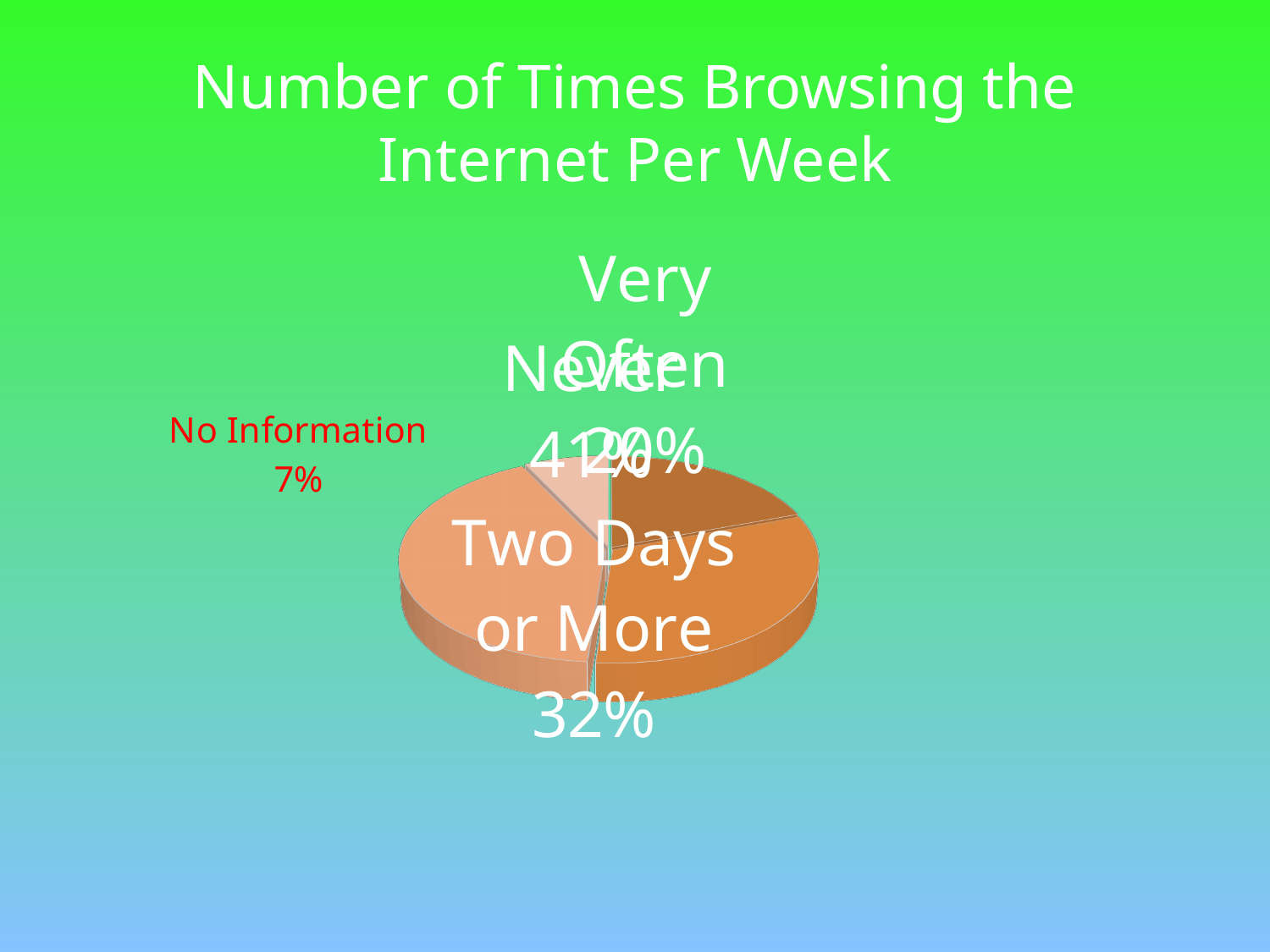
What colour is the text of the "No Information" label? red Which category has the smallest share of the pie? No Information What percentage of the pie is labelled "Two Days or More"? 32% What kind of chart is shown on the slide? pie chart What is the title of the chart? Number of Times Browsing the Internet Per Week How many percentage points larger is the "Two Days or More" share than the "No Information" share? 25 How many categories (slices) does the pie chart have? 4 Which is larger, the share for "Two Days or More" or the share for "No Information"? Two Days or More What percentage of the pie is labelled "No Information"? 7%